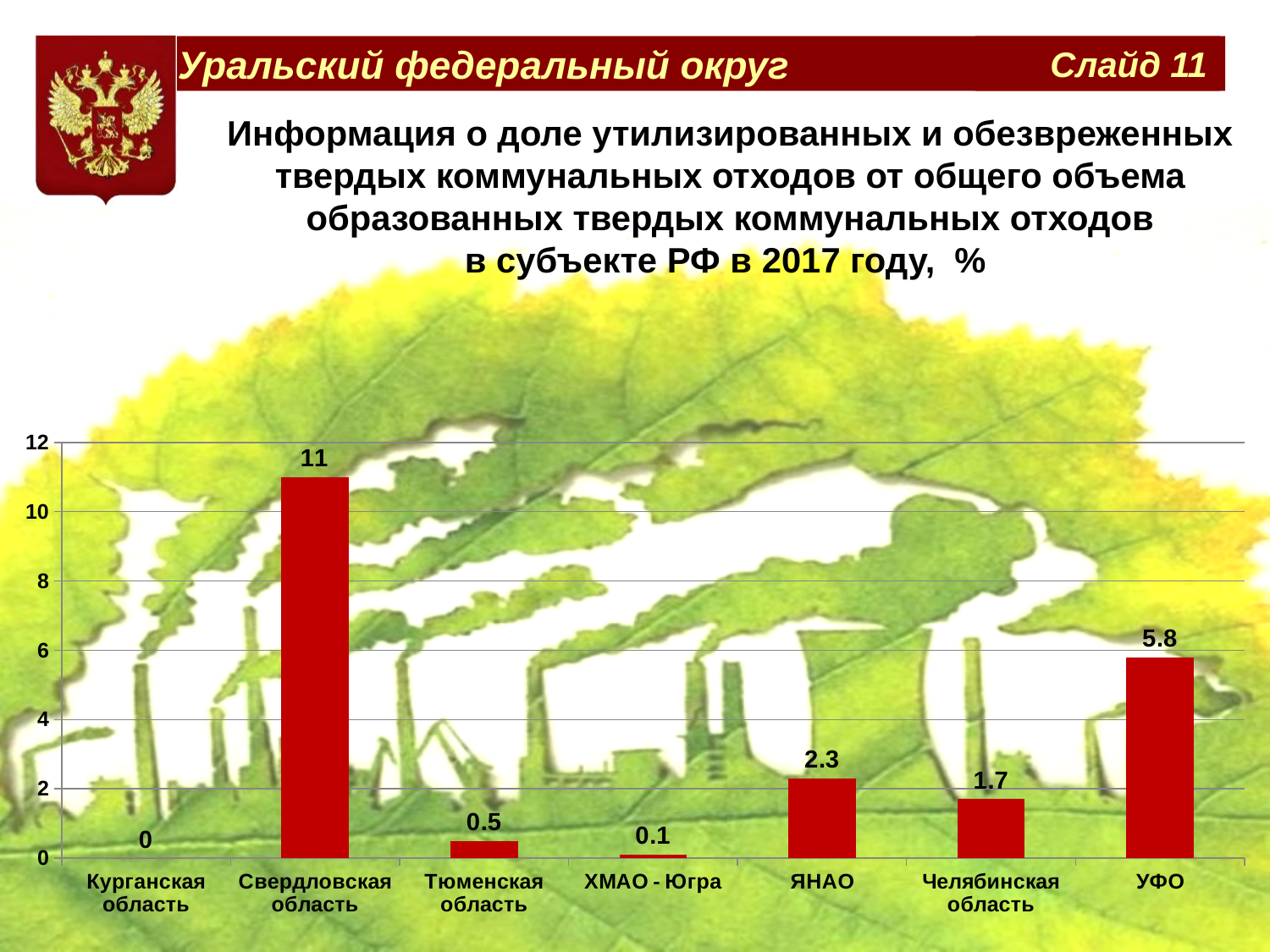
What is the value for Свердловская область? 11 What is the value for Челябинская область? 1.7 Which is larger, the value for ЯНАО or the value for Челябинская область? ЯНАО How many categories are shown on the x axis? 7 What is the value for Курганская область? 0 What is the value for УФО? 5.8 Is the value for УФО greater or less than 4? greater Which category has the highest value? Свердловская область What kind of chart is shown on the slide? bar chart Which category has the lowest value? Курганская область What is the difference between the values for Свердловская область and УФО? 5.2 What is the value for ЯНАО? 2.3